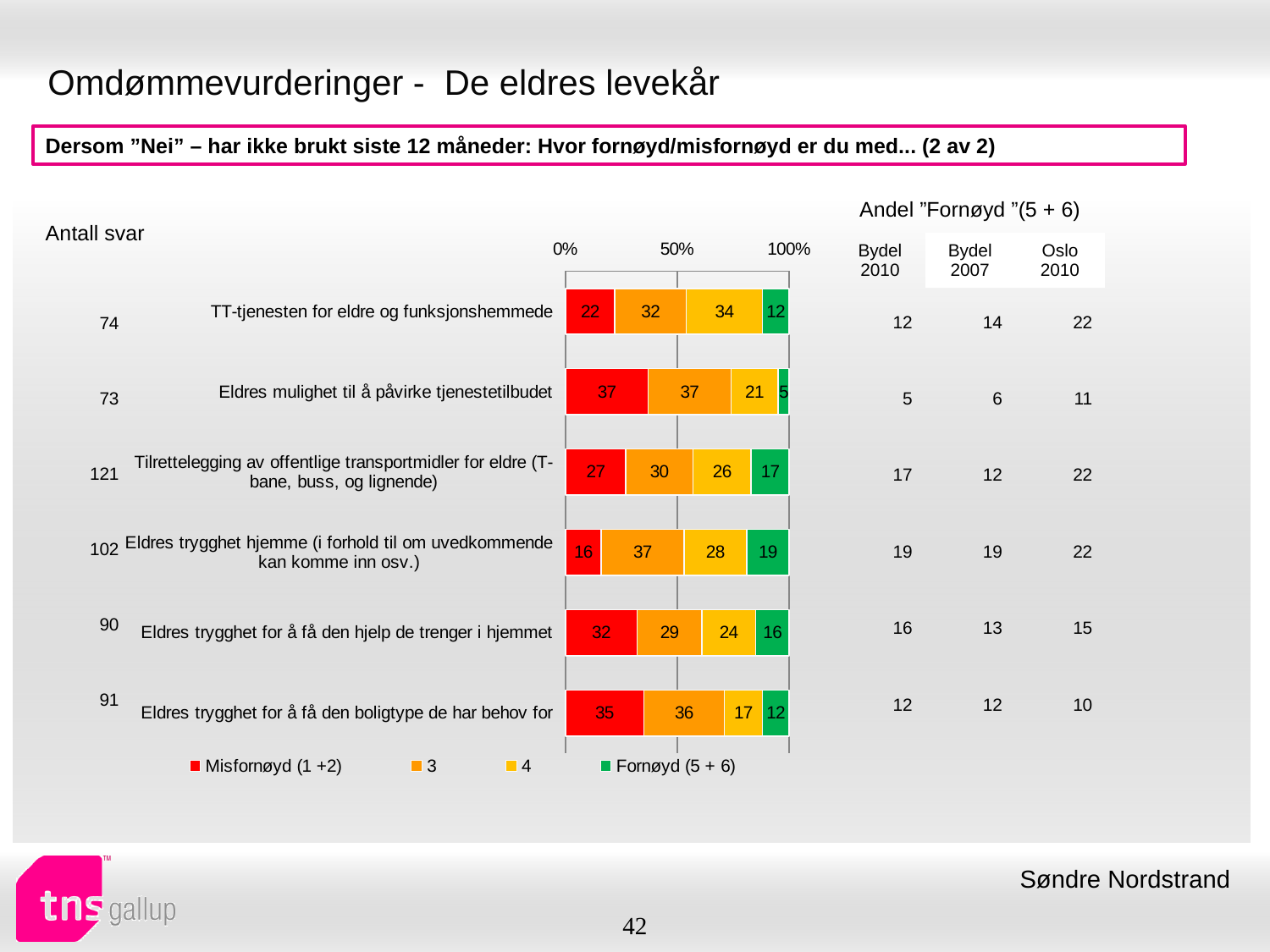
What is the difference between the Misfornøyd (1 +2) values for 'Eldres trygghet for å få den boligtype de har behov for' and 'Eldres trygghet hjemme (i forhold til om uvedkommende kan komme inn osv.)'? 19 Which category has the lowest Fornøyd (5 + 6) value? Eldres mulighet til å påvirke tjenestetilbudet What is the value of series '3' for 'Eldres trygghet for å få den boligtype de har behov for'? 36 Which category has the highest Misfornøyd (1 +2) value? Eldres mulighet til å påvirke tjenestetilbudet What is the total of the stacked bar for 'Eldres trygghet for å få den hjelp de trenger i hjemmet'? 101 How many categories (bars) are shown in the chart? 6 How many series does the chart legend list? 4 What is the Fornøyd (5 + 6) value for 'Eldres trygghet hjemme (i forhold til om uvedkommende kan komme inn osv.)'? 19 What is the Misfornøyd (1 +2) value for 'TT-tjenesten for eldre og funksjonshemmede'? 22 Which colour represents the Fornøyd (5 + 6) series in the chart? green What kind of chart is shown on the slide? stacked bar chart Which has a larger Fornøyd (5 + 6) value: 'Tilrettelegging av offentlige transportmidler for eldre (T-bane, buss, og lignende)' or 'TT-tjenesten for eldre og funksjonshemmede'? Tilrettelegging av offentlige transportmidler for eldre (T-bane, buss, og lignende)